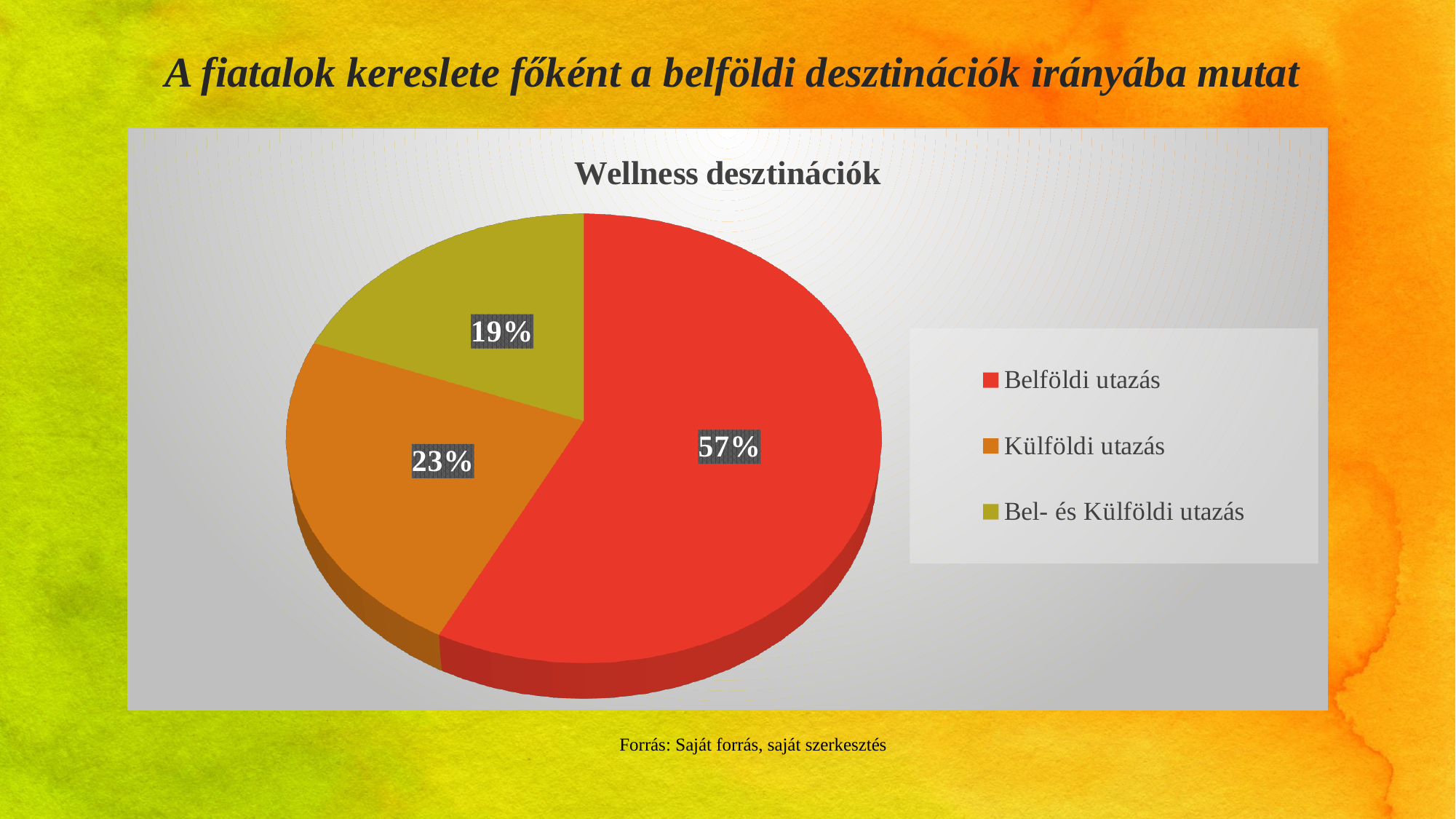
What is the difference in percentage points between Belföldi utazás and Külföldi utazás? 34 What kind of chart is shown on the slide? Pie chart Which colour represents Külföldi utazás in the chart? Orange What share of the pie does Bel- és Külföldi utazás have? 19% Which is larger, the share for Külföldi utazás or for Bel- és Külföldi utazás? Külföldi utazás How many categories does the pie chart show? 3 What is the title of the chart? Wellness desztinációk What share of the pie does Belföldi utazás have? 57% Which category has the largest slice of the pie? Belföldi utazás What share of the pie does Külföldi utazás have? 23% Which category has the smallest slice of the pie? Bel- és Külföldi utazás What is the difference in percentage points between Külföldi utazás and Bel- és Külföldi utazás? 4